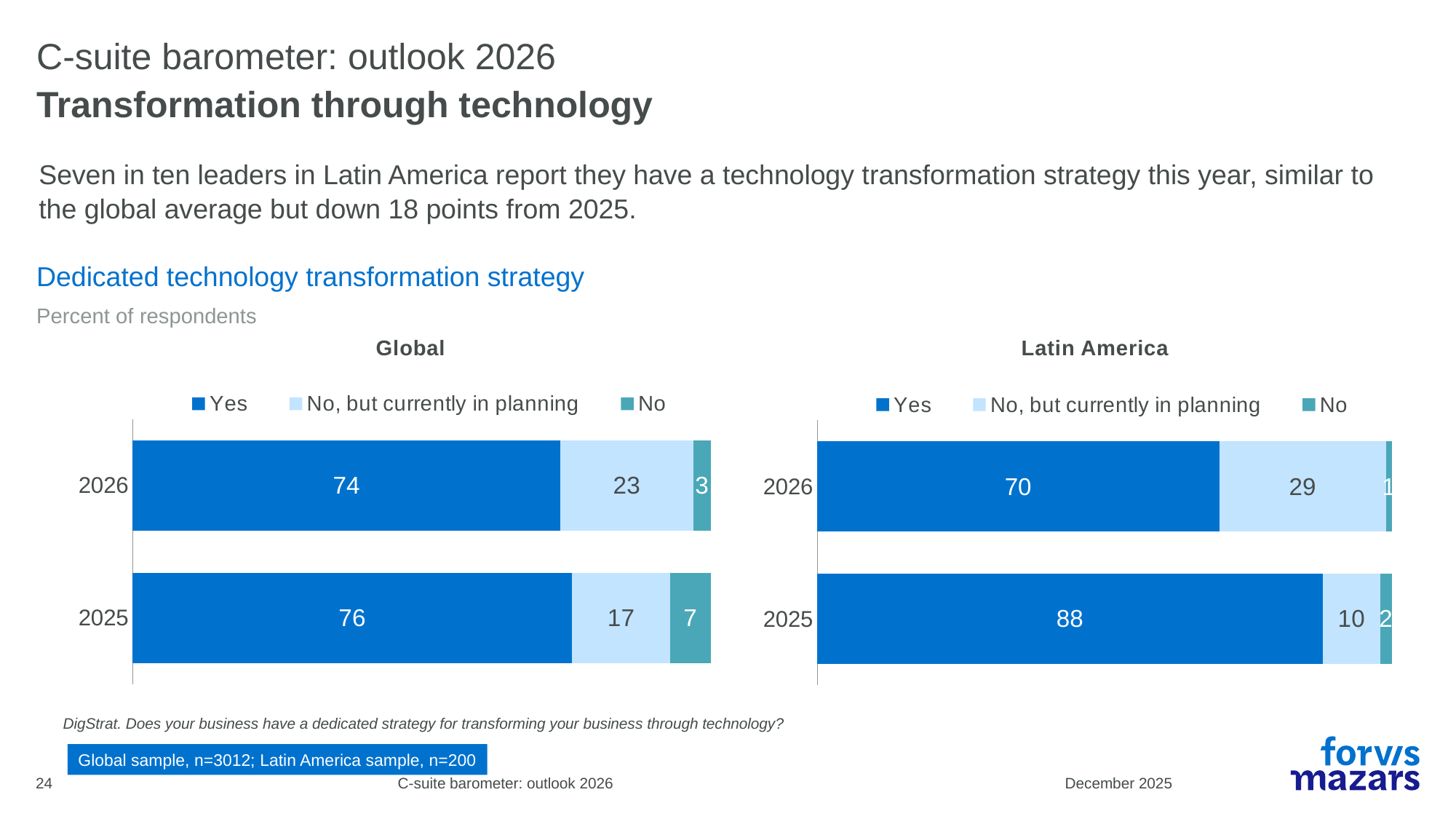
In the Global chart, what is the difference between the No, but currently in planning values for 2026 and 2025? 6 In the Global chart, which year has the larger Yes value, 2025 or 2026? 2025 In the Latin America chart, which year has the larger No, but currently in planning value? 2026 How many years are shown in the Latin America chart? 2 In the Global chart, what is the value for No in 2025? 7 In the Global chart, what is the value for Yes in 2026? 74 In the Latin America chart, what is the value for No, but currently in planning in 2026? 29 In the Latin America chart, what is the value for Yes in 2025? 88 What kind of chart is the Global chart? Stacked bar chart In the Latin America chart, what is the difference between the Yes values for 2025 and 2026? 18 In the Global chart, what is the total of the stacked bar for 2026? 100 How many series does the legend of the Global chart list? 3